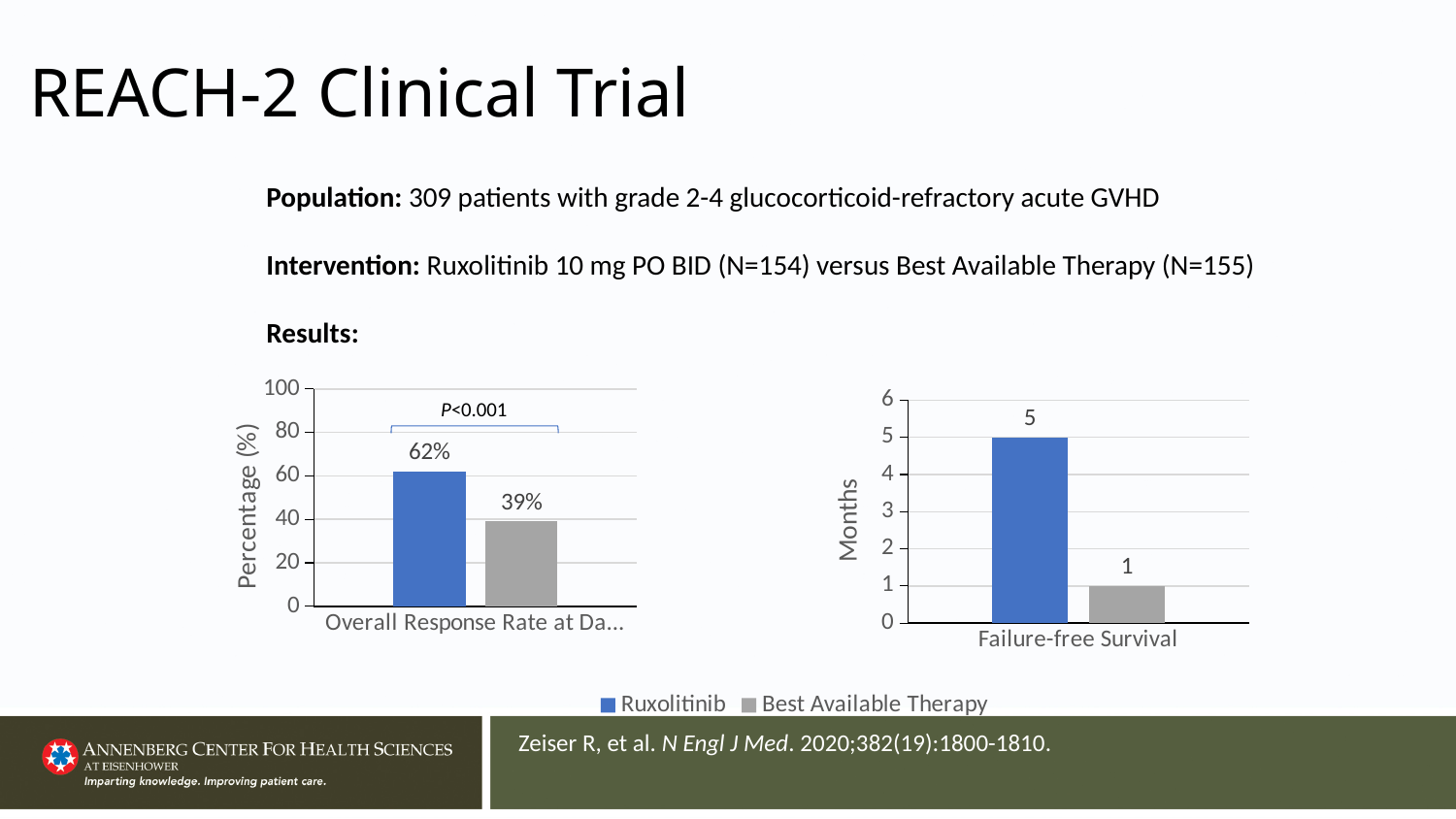
What P value is shown above the bars in the left chart (Overall Response Rate)? P<0.001 In the left chart (Overall Response Rate), which series has the higher value? Ruxolitinib What is the y-axis label of the right chart (Failure-free Survival)? Months In the right chart (Failure-free Survival), what is the value for Ruxolitinib? 5 In the left chart (Overall Response Rate), what is the value for Ruxolitinib? 62% In the right chart (Failure-free Survival), which series has the lowest value? Best Available Therapy In the right chart (Failure-free Survival), what is the difference in months between Ruxolitinib and Best Available Therapy? 4 In the right chart (Failure-free Survival), what is the value for Best Available Therapy? 1 What kind of chart is the right chart (Failure-free Survival)? Bar chart How many series does the legend list? 2 In the left chart (Overall Response Rate), what is the value for Best Available Therapy? 39% In the left chart (Overall Response Rate), what is the difference between the Ruxolitinib and Best Available Therapy values? 23%